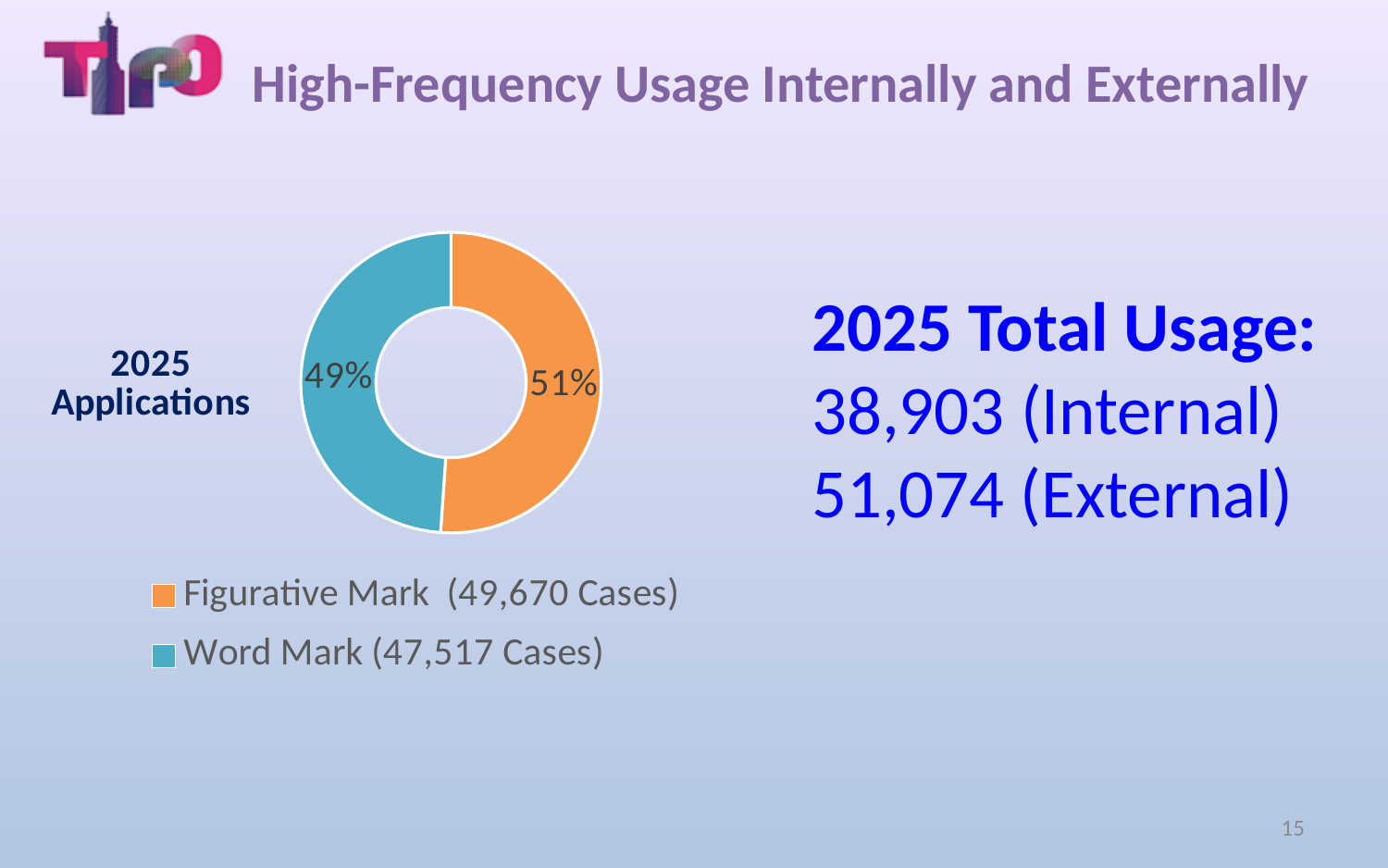
What share of the pie does Figurative Mark account for? 51% How many categories does the pie chart show? 2 What is the difference in percentage points between the Figurative Mark share and the Word Mark share? 2 percentage points How many cases does the legend give for Figurative Mark? 49,670 Cases What share of the pie does Word Mark account for? 49% Which category has the smallest slice of the pie? Word Mark How many cases does the legend give for Word Mark? 47,517 Cases Which is larger, the share for Figurative Mark or the share for Word Mark? Figurative Mark How many more cases are there for Figurative Mark than for Word Mark? 2,153 What kind of chart is shown on the slide? doughnut chart Which category has the largest slice of the pie? Figurative Mark What colour is the Figurative Mark slice? orange